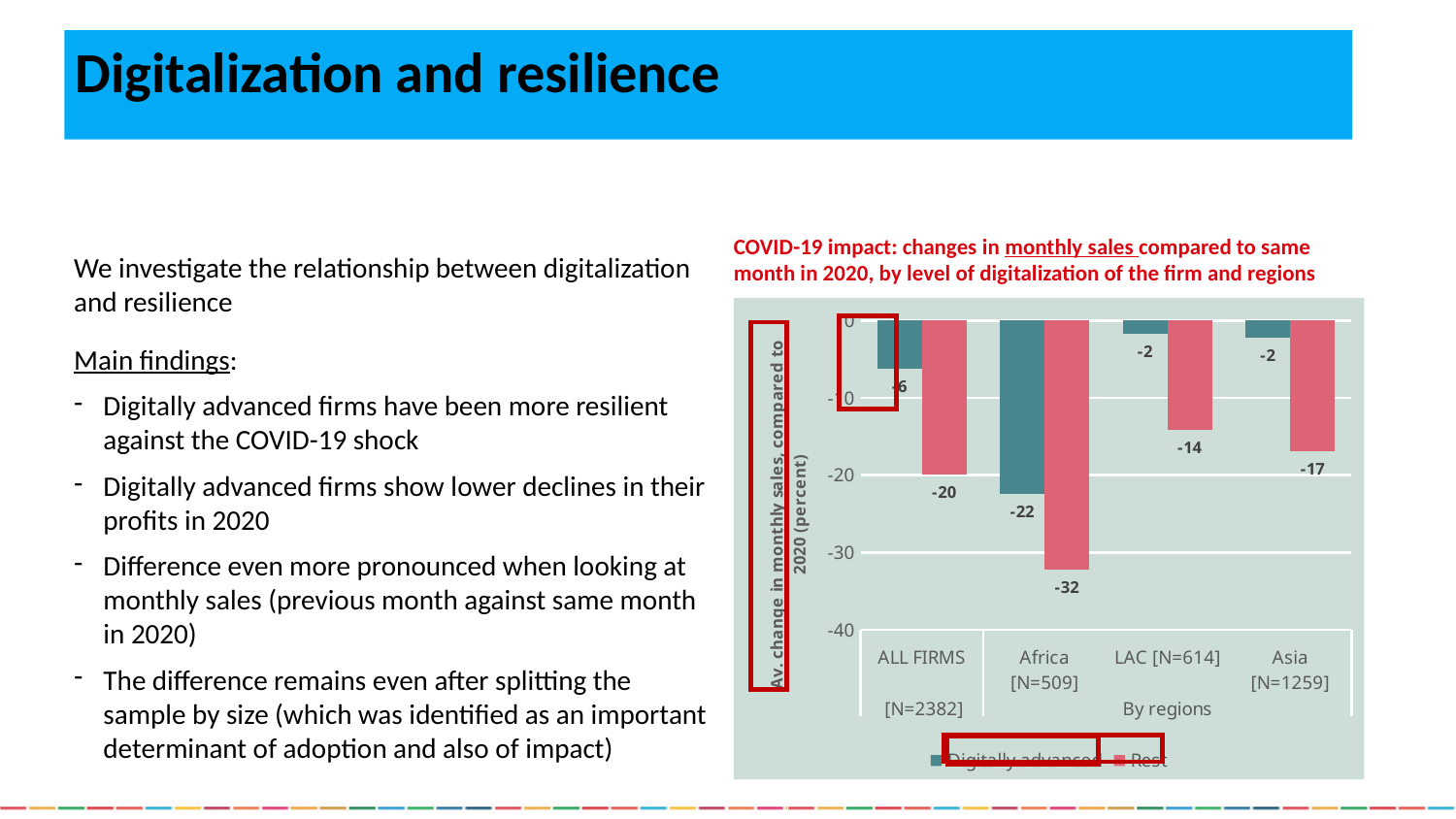
What is the value for Digitally advanced firms in the ALL FIRMS category? -6 What is the value for Digitally advanced firms in Asia? -2 Which region shows the lowest value for the Rest series? Africa Which is larger in Africa, the value for Digitally advanced firms or for Rest firms? Digitally advanced How many categories are shown on the x axis of the chart? 4 What is the value for Rest firms in LAC? -14 What kind of chart is shown on the slide? bar chart What is the difference between the Rest and Digitally advanced values for ALL FIRMS? 14 What does the y axis of the chart measure? Av. change in monthly sales, compared to 2020 (percent) What is the value for Rest firms in Africa? -32 What is the difference between the Rest and Digitally advanced values in Asia? 15 How many series does the chart's legend list? 2